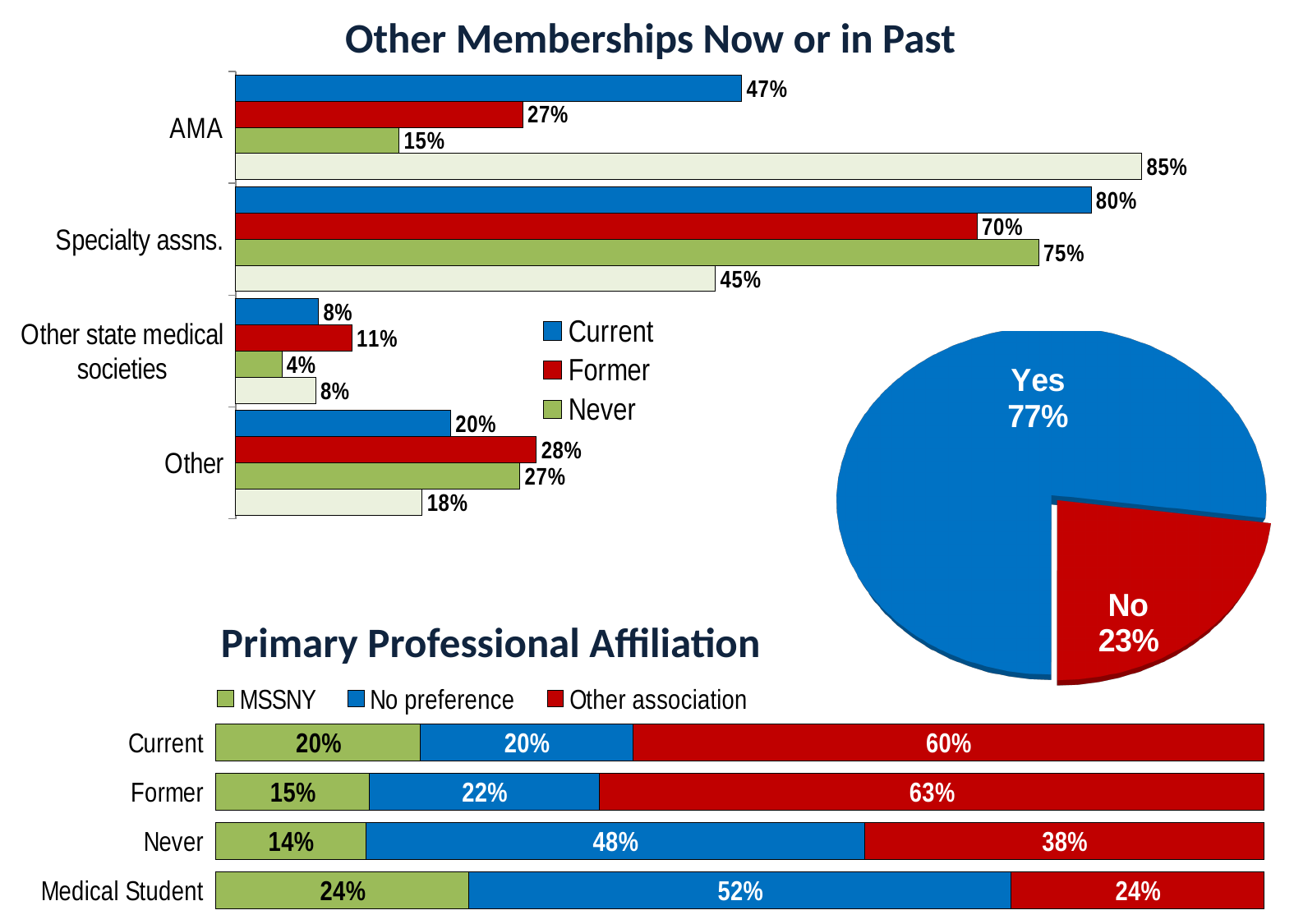
In the 'Other Memberships Now or in Past' chart, which is larger for Other: the Former value or the Current value? Former In the 'Other Memberships Now or in Past' chart, what is the difference between the Current and Former values for AMA? 20% In the 'Primary Professional Affiliation' chart, what is the No preference value for Never? 48% In the 'Other Memberships Now or in Past' chart, what is the Never value for Other state medical societies? 4% In the 'Other Memberships Now or in Past' chart, which category has the highest Current value? Specialty assns. In the 'Primary Professional Affiliation' chart, which category has the highest Other association value? Former How many categories are shown in the 'Primary Professional Affiliation' chart? 4 In the pie chart on the right, what share is labelled 'No'? 23% How many series does the legend of the 'Other Memberships Now or in Past' chart list? 3 In the 'Other Memberships Now or in Past' chart, what is the Former value for Specialty assns.? 70% What kind of chart is the chart on the right showing Yes and No? Pie chart In the 'Other Memberships Now or in Past' chart, what is the Current value for AMA? 47%